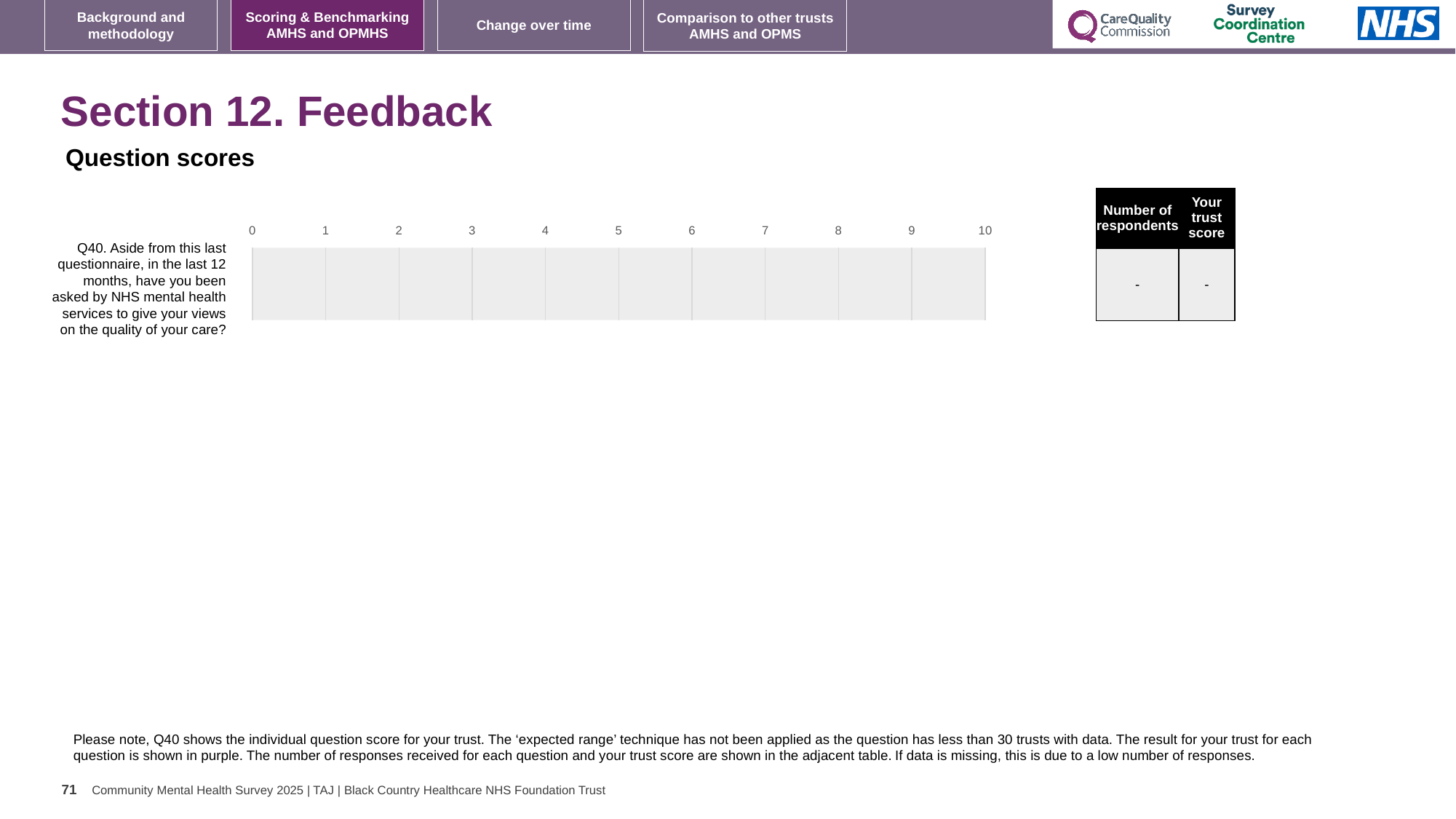
What kind of chart is shown on the slide? bar chart What value is shown in the 'Number of respondents' column of the table for Q40? - Which question number is the category on the chart? Q40 What value is shown in the 'Your trust score' column of the table for Q40? - Is a bar plotted for Q40 on the chart? No How many question categories are listed on the chart's vertical axis? 1 What is the lowest value shown on the chart's horizontal axis? 0 What is the highest value shown on the chart's horizontal axis? 10